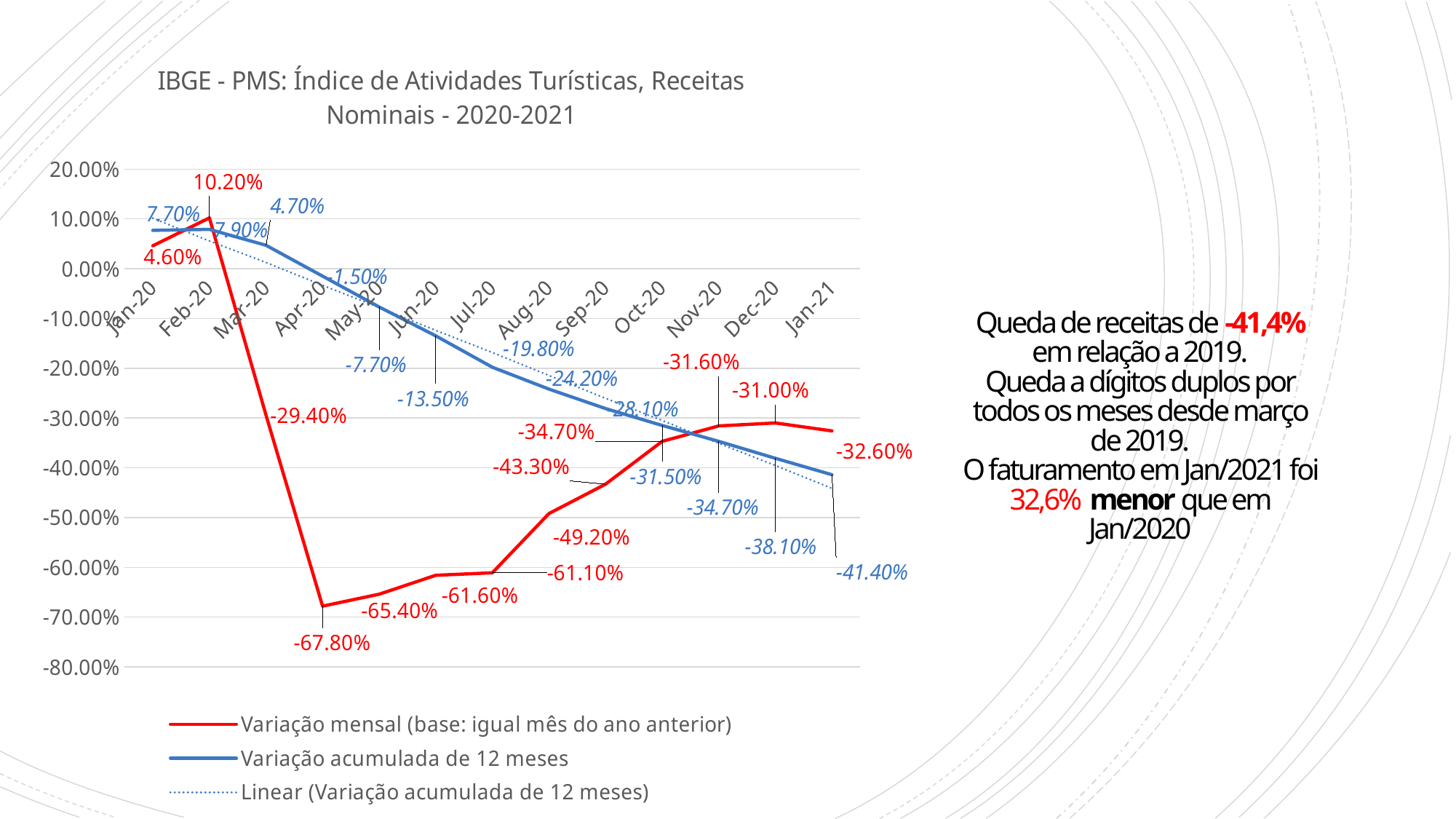
In which month does 'Variação mensal (base: igual mês do ano anterior)' reach its highest value? Feb-20 Does 'Variação acumulada de 12 meses' rise or fall from Feb-20 to Jan-21? Fall By how many percentage points does 'Variação mensal' in Feb-20 exceed 'Variação mensal' in Jan-20? 5.60 percentage points What is the difference between 'Variação acumulada de 12 meses' in Dec-20 and in Jan-21? 3.30 percentage points What type of chart is shown on the slide? Line chart What is the value of 'Variação mensal (base: igual mês do ano anterior)' for Dec-20? -31.00% In which month does 'Variação mensal (base: igual mês do ano anterior)' reach its lowest value? Apr-20 For Oct-20, which series has the larger value: 'Variação mensal' or 'Variação acumulada de 12 meses'? Variação acumulada de 12 meses What is the value of 'Variação mensal (base: igual mês do ano anterior)' for Apr-20? -67.80% How many entries does the legend list? 3 How many months are plotted on the x axis? 13 What is the value of 'Variação acumulada de 12 meses' for Jan-21? -41.40%